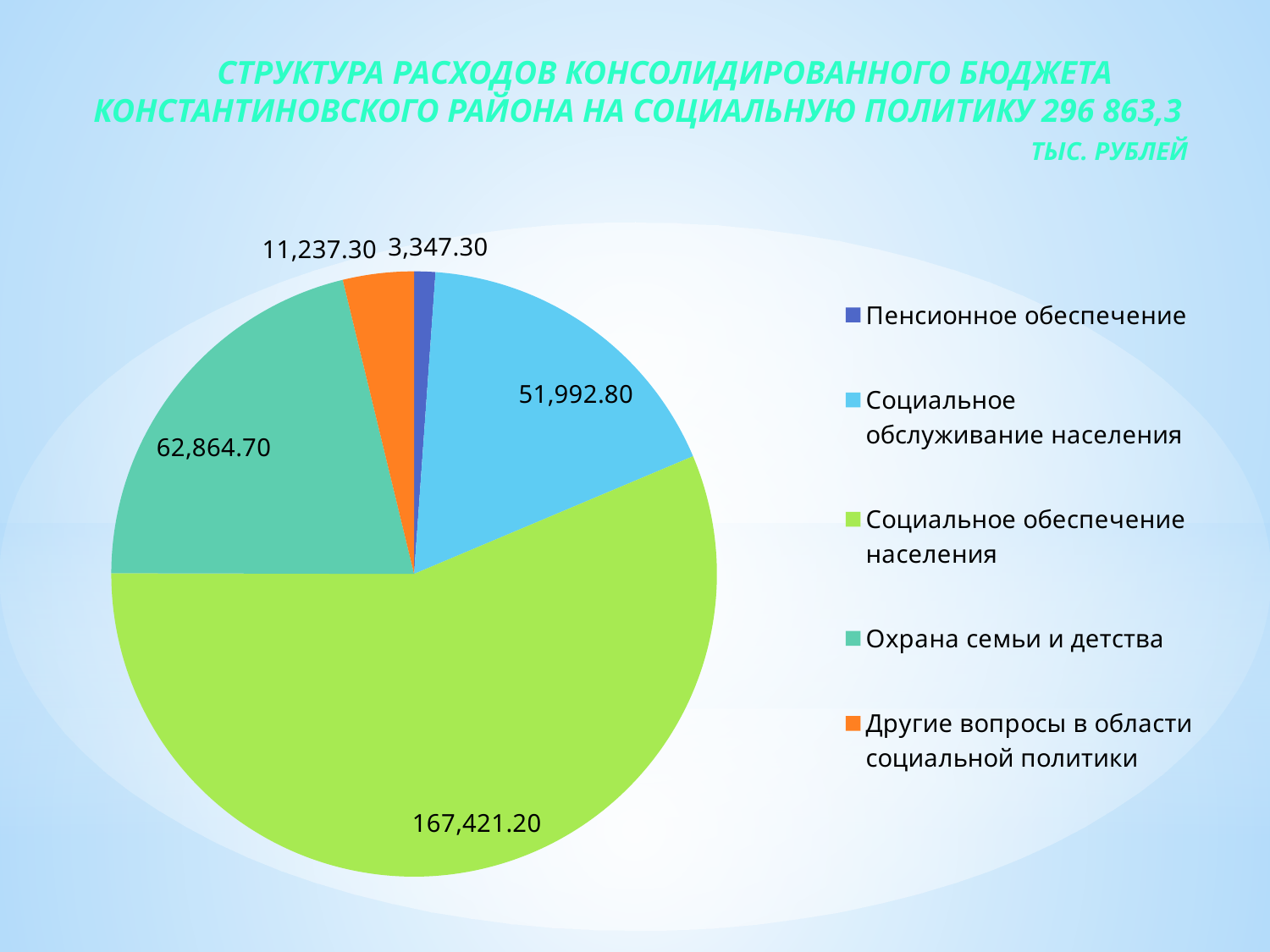
Which is larger: Социальное обслуживание населения or Другие вопросы в области социальной политики? Социальное обслуживание населения How many slices does the pie chart have? 5 What colour is the slice for Охрана семьи и детства? Teal (green-blue) What is the value for Другие вопросы в области социальной политики? 11,237.30 What is the value for Охрана семьи и детства? 62,864.70 What is the value for Пенсионное обеспечение? 3,347.30 Which category has the smallest slice of the pie? Пенсионное обеспечение What type of chart is shown on the slide? Pie chart What is the difference between the values for Социальное обеспечение населения and Охрана семьи и детства? 104,556.50 What is the difference between the values for Охрана семьи и детства and Социальное обслуживание населения? 10,871.90 Which category has the largest slice of the pie? Социальное обеспечение населения What is the value for Социальное обеспечение населения? 167,421.20